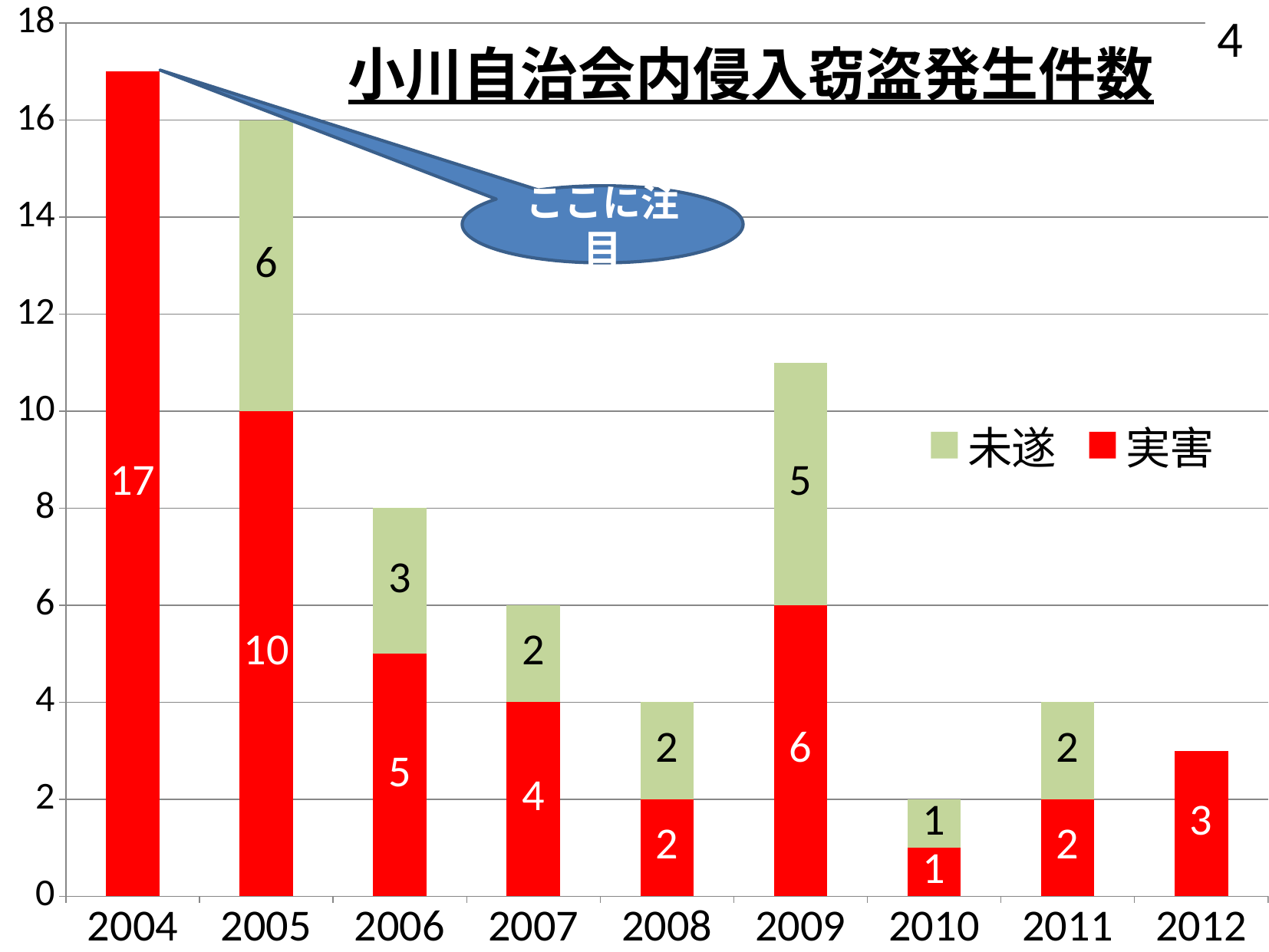
What is the 実害 value for 2004? 17 What is the 未遂 value for 2009? 5 Which year has the highest 実害 value? 2004 What is the total of the stacked bar for 2006? 8 How many years are shown on the x axis? 9 What is the difference between the 実害 values for 2005 and 2006? 5 Which year has the lowest 実害 value? 2010 Which is larger, the 未遂 value for 2005 or the 未遂 value for 2009? 2005 What is the title of the chart? 小川自治会内侵入窃盗発生件数 What is the total of the stacked bar for 2009? 11 What is the 実害 value for 2012? 3 How many series does the legend list? 2